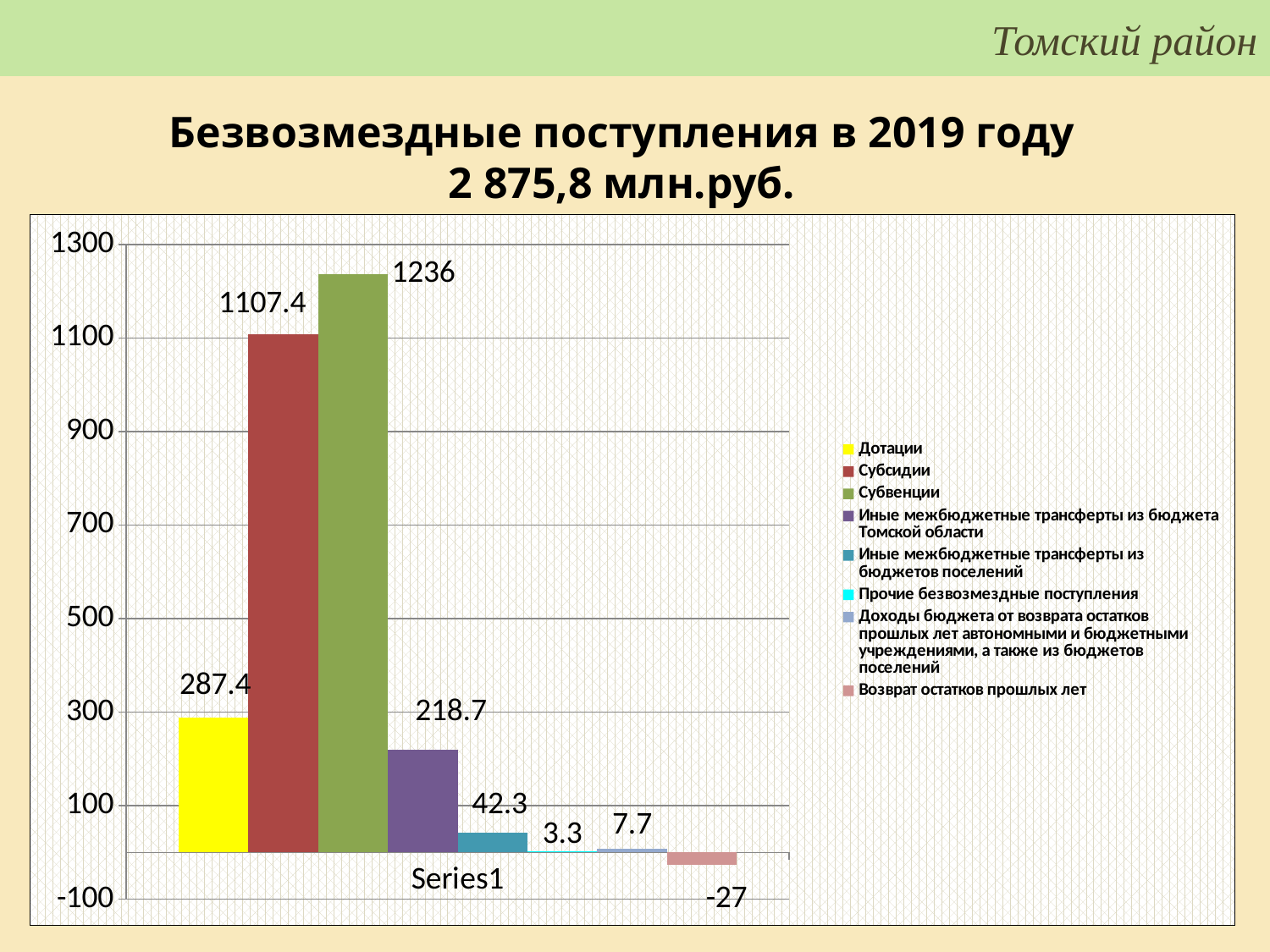
What is the value for Возврат остатков прошлых лет? -27 What is the difference between the values for Субвенции and Субсидии? 128.6 What kind of chart is shown on the slide? Bar chart What is the value for Прочие безвозмездные поступления? 3.3 Which is larger, the value for Дотации or the value for Иные межбюджетные трансферты из бюджета Томской области? Дотации Which series has the highest value? Субвенции How many series does the legend list? 8 Which series has the lowest value? Возврат остатков прошлых лет What is the value for Субсидии? 1107.4 What is the value for Субвенции? 1236 What is the value for Дотации? 287.4 What is the title of the slide above the chart? Безвозмездные поступления в 2019 году 2 875,8 млн.руб.